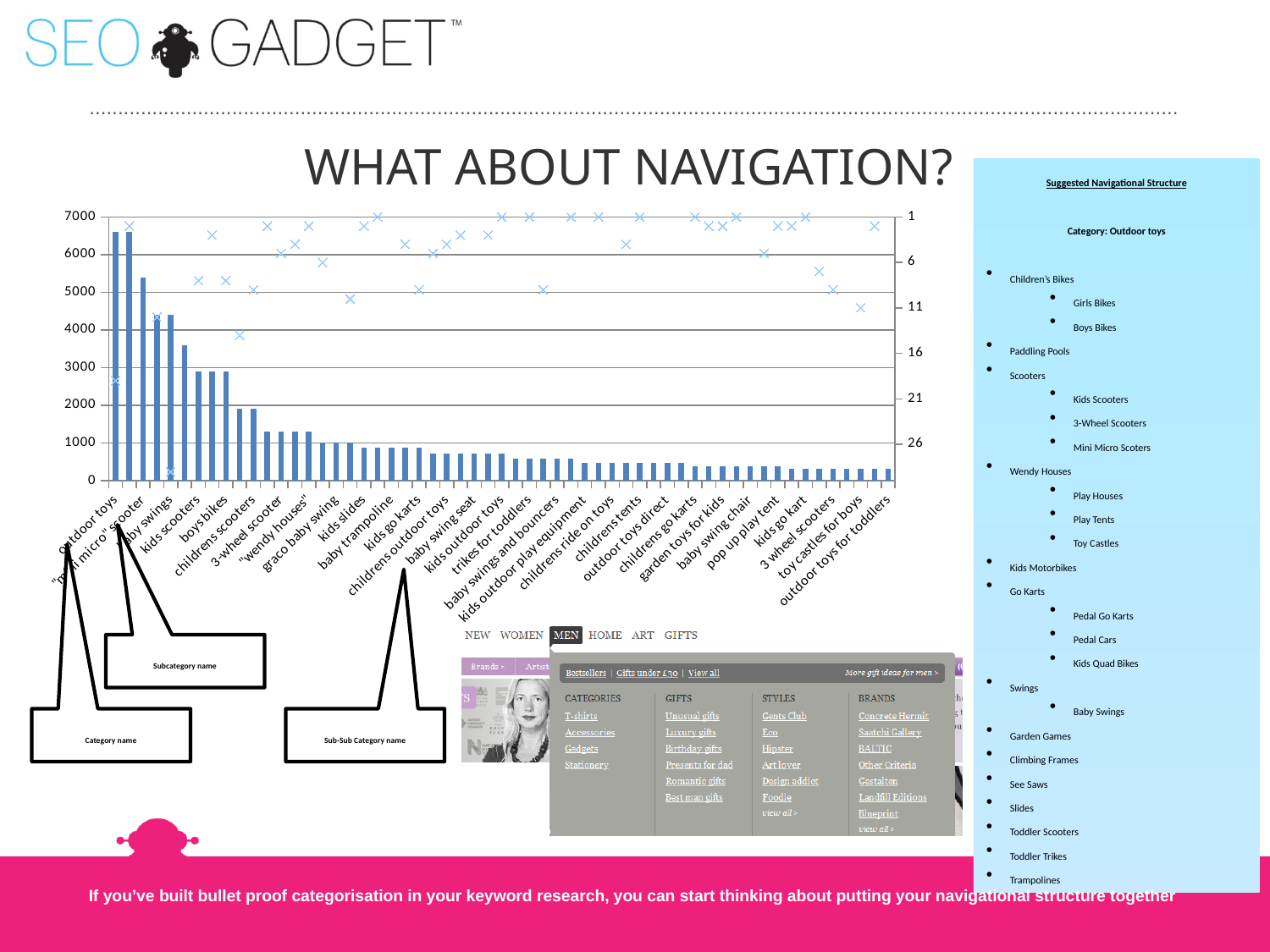
Is the bar value for "outdoor toys for toddlers" greater or less than 1000? less Are the tallest bars at the left end or the right end of the chart? left end Do the bar values rise or fall moving from left to right along the x axis? fall Is the bar value for "outdoor toys" greater or less than 6000? greater What is the lowest tick value shown on the right vertical axis? 1 What is the highest value shown on the left vertical axis? 7000 Is the bar value for "kids slides" greater or less than 2000? less Which is larger, the bar for "outdoor toys" or the bar for "boys bikes"? outdoor toys What kind of chart is shown on the slide? bar chart (with X markers on a secondary axis)